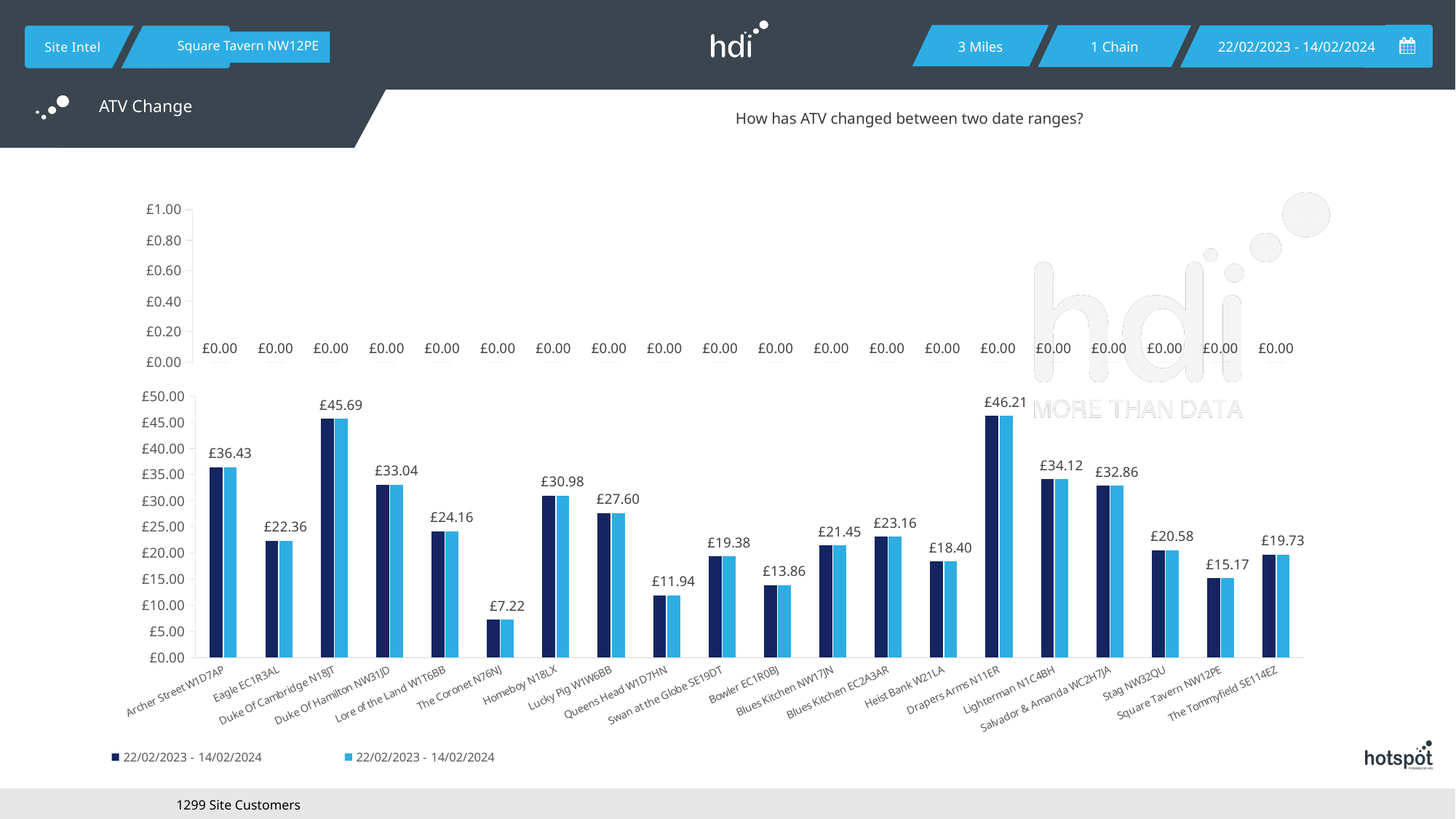
What kind of chart is used on this slide? Bar chart What is the difference between the ATV values for Homeboy N18LX and Lucky Pig W1W6BB? £3.38 Which site has the lowest ATV value in the lower chart? The Coronet N76NJ How many sites are shown along the x axis of the chart? 20 What is the ATV value shown for The Coronet N76NJ? £7.22 Which has a higher ATV value, Lighterman N1C4BH or Salvador & Amanda WC2H7JA? Lighterman N1C4BH What value is shown for every site in the upper panel of the chart? £0.00 What is the ATV value shown for Square Tavern NW12PE? £15.17 What is the ATV value shown for Archer Street W1D7AP? £36.43 What is the difference between the ATV values for Drapers Arms N11ER and Duke Of Cambridge N18JT? £0.52 How many series does the legend list? 2 Which site has the highest ATV value in the lower chart? Drapers Arms N11ER